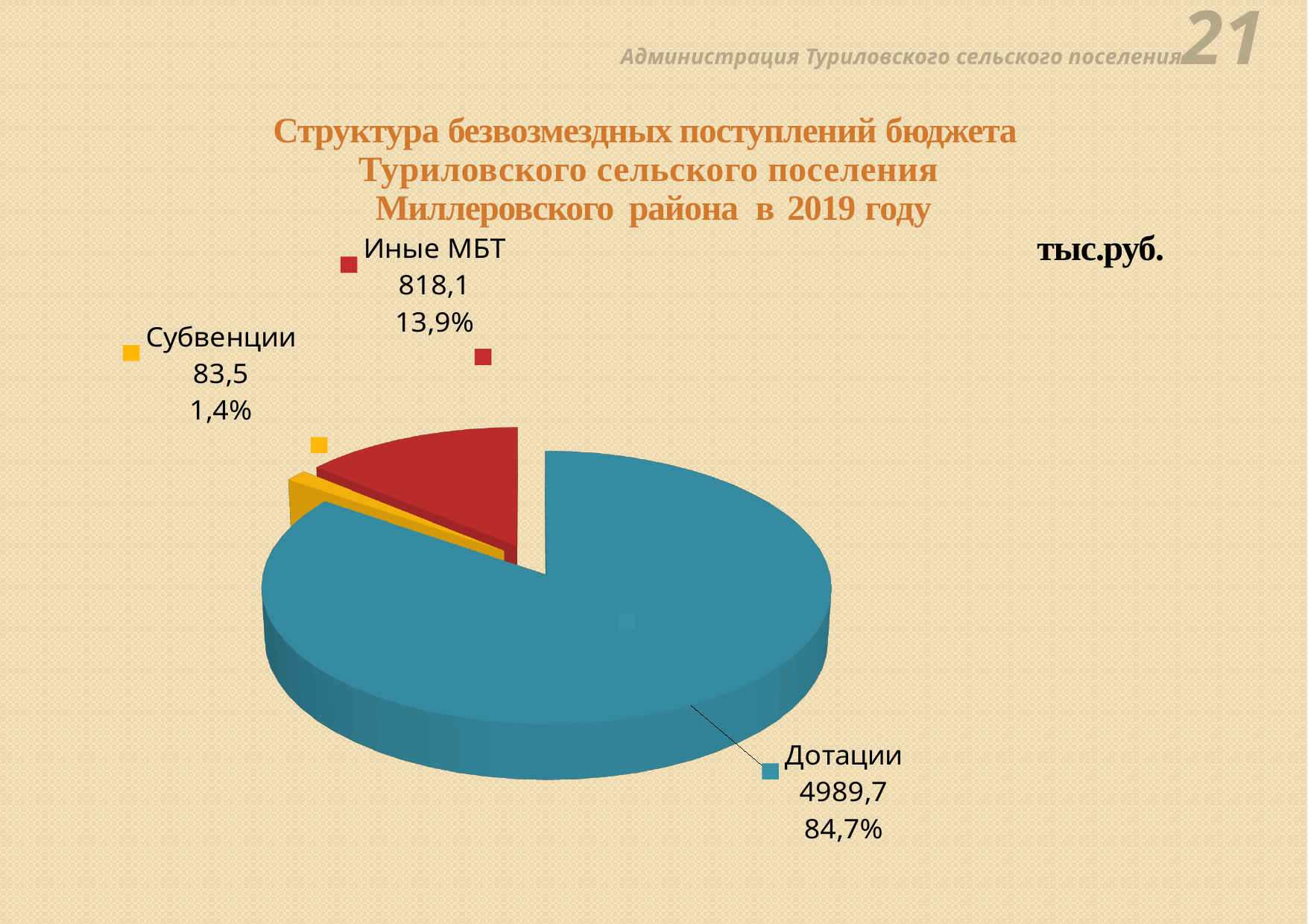
What share of the pie does Иные МБТ represent? 13,9% What is the value for Иные МБТ? 818,1 Which category has the smallest slice? Субвенции What share of the pie does Дотации represent? 84,7% What type of chart is shown on the slide? Pie chart What is the value for Субвенции? 83,5 What share of the pie does Субвенции represent? 1,4% What is the value for Дотации? 4989,7 How many slices does the pie chart have? 3 What unit of measurement is indicated on the slide for the chart values? тыс.руб. What is the difference between the values for Иные МБТ and Субвенции? 734,6 Which category has the largest slice? Дотации